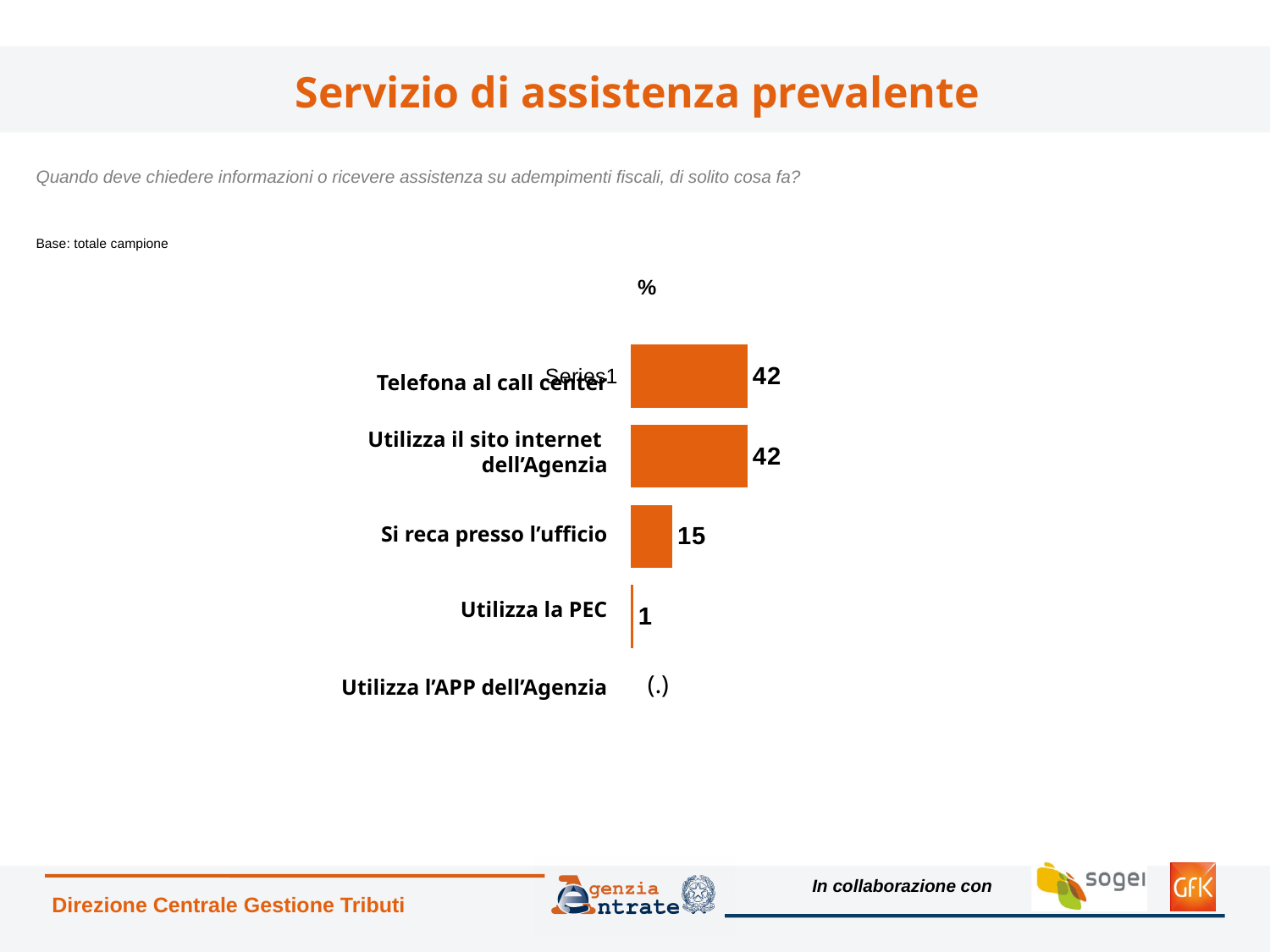
Which category shows "(.)" instead of a numeric value? Utilizza l'APP dell'Agenzia Which is larger, the value for "Si reca presso l'ufficio" or the value for "Utilizza la PEC"? Si reca presso l'ufficio What is the value for "Telefona al call center"? 42 Which is larger, the value for "Utilizza il sito internet dell'Agenzia" or the value for "Si reca presso l'ufficio"? Utilizza il sito internet dell'Agenzia What is the title of the slide containing the chart? Servizio di assistenza prevalente What is the difference between the values for "Telefona al call center" and "Si reca presso l'ufficio"? 27 What is the value for "Utilizza la PEC"? 1 What kind of chart is shown on the slide? bar chart How many categories are shown in the chart? 5 What is the difference between the values for "Si reca presso l'ufficio" and "Utilizza la PEC"? 14 What is the value for "Utilizza il sito internet dell'Agenzia"? 42 What is the value for "Si reca presso l'ufficio"? 15